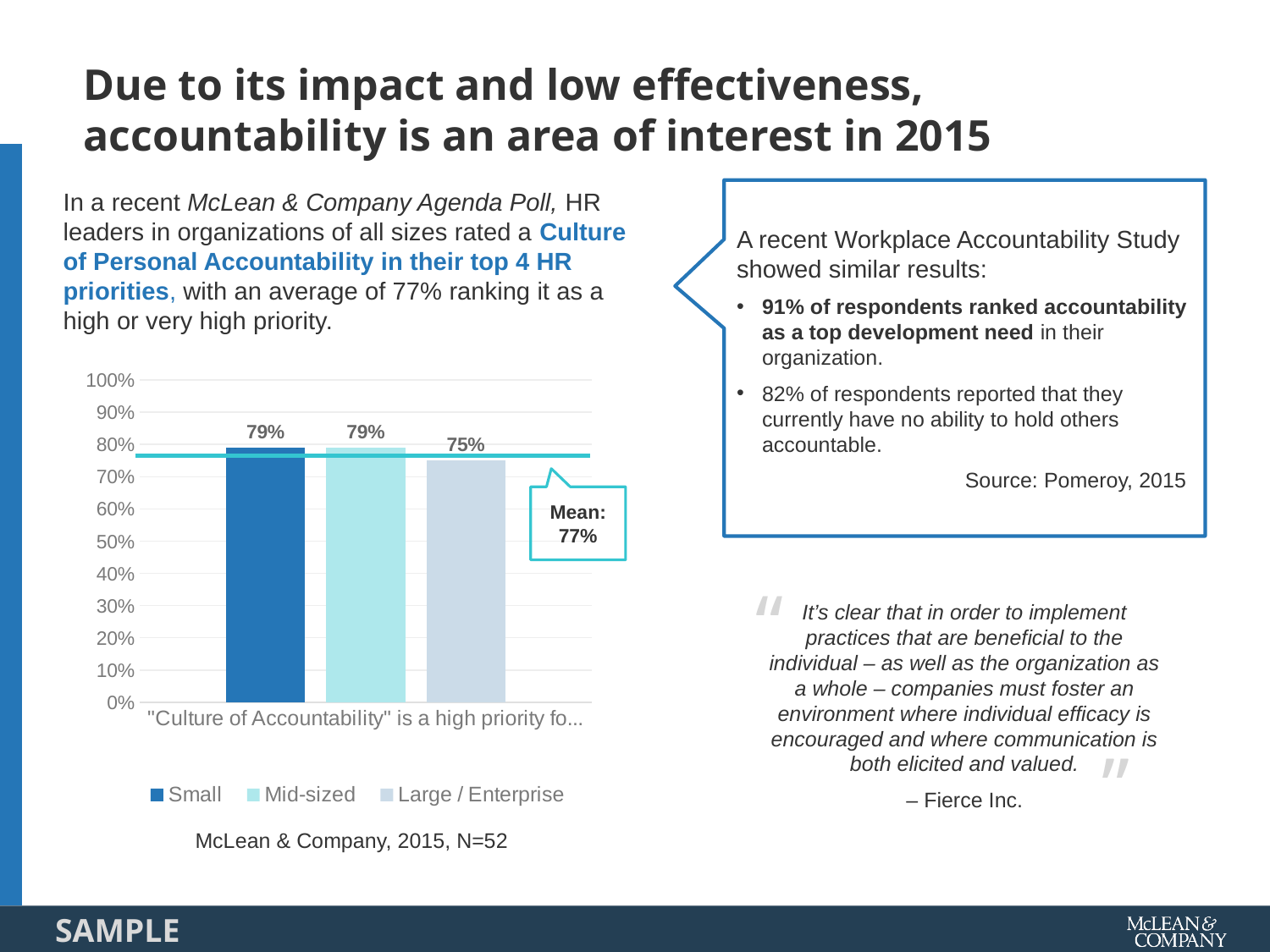
What is the difference between the Small value and the Large / Enterprise value in the bar chart? 4 percentage points What is the value for the Small series in the bar chart? 79% What mean value is marked by the horizontal line on the bar chart? 77% What are the three legend entries of the bar chart? Small, Mid-sized, Large / Enterprise What sample size (N) is given in the source note below the bar chart? N=52 What kind of chart is shown on the slide? Bar chart How many series does the legend of the bar chart list? 3 Which is larger in the bar chart, the value for Mid-sized or the value for Large / Enterprise? Mid-sized Which series has the lowest value in the bar chart? Large / Enterprise Is the value for Large / Enterprise greater or less than 70%? greater What is the value for the Large / Enterprise series in the bar chart? 75% What is the value for the Mid-sized series in the bar chart? 79%